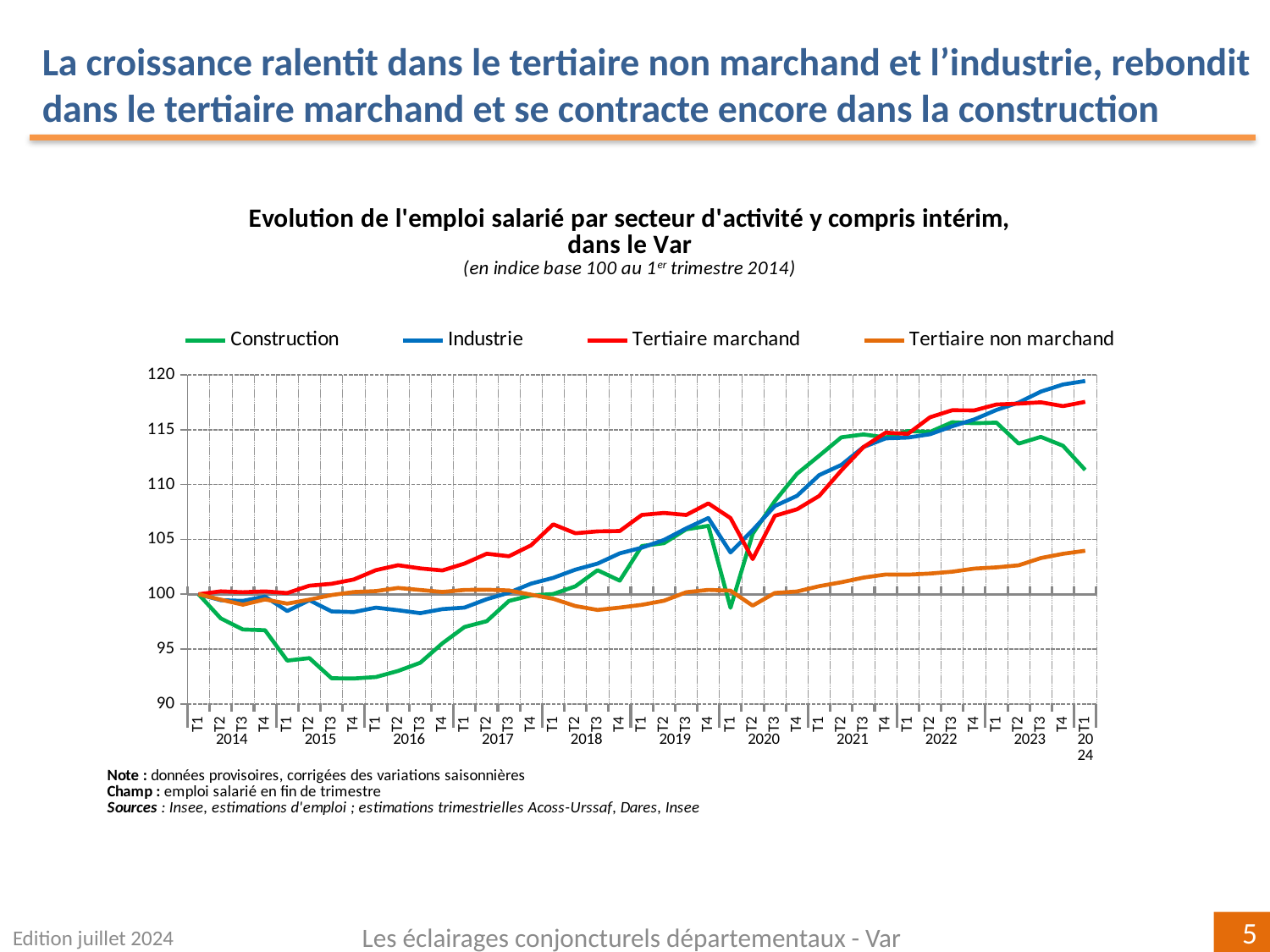
At T1 2024, which is higher: Industrie or Construction? Industrie Does the Construction series rise or fall between T1 2014 and T4 2015? fall Does the Industrie series rise or fall between T1 2021 and T1 2024? rise Which series has the lowest value at T1 2024? Tertiaire non marchand Is the value for Tertiaire non marchand at T1 2024 greater or less than 105? less Is the value for Construction at T4 2015 greater or less than 95? less Is the value for Industrie at T1 2024 greater or less than 115? greater What is the index value of all four series at T1 2014? 100 What type of chart is shown on the slide? line chart Which series is shown in green in the legend? Construction How many series does the legend list? 4 Which series has the highest value at T1 2024? Industrie